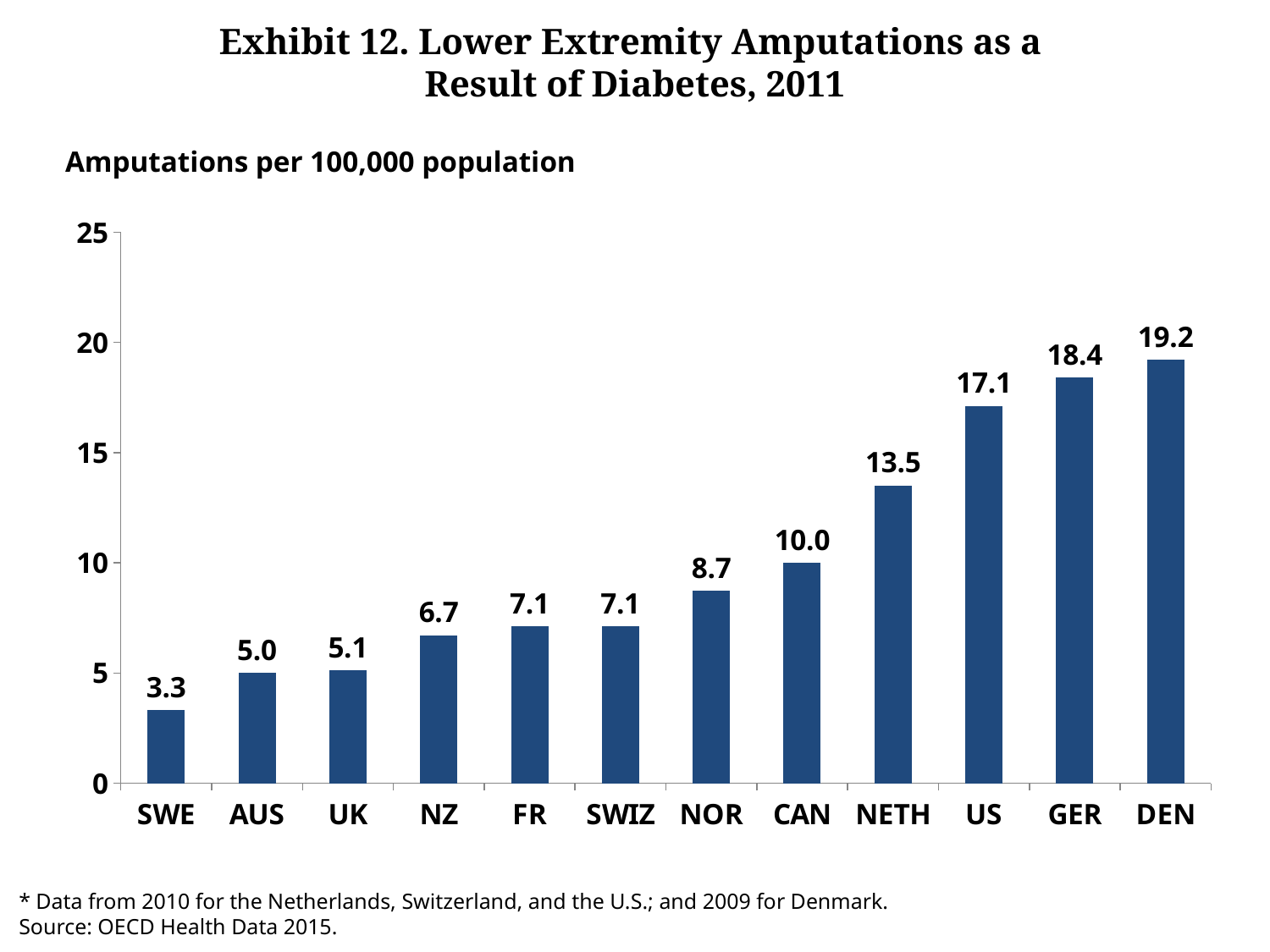
Which country has the highest value? DEN What is the difference between the values for GER and the US? 1.3 What is the value for the US? 17.1 How many countries are shown on the chart? 12 What kind of chart is shown on the slide? bar chart Which country has the lowest value? SWE Do the values rise or fall from left to right along the x axis? rise Is the value for NOR greater or less than 10? less What unit is given for the values on the chart? Amputations per 100,000 population What is the difference between the values for DEN and SWE? 15.9 Which is larger, the value for NETH or the value for CAN? NETH What is the value for NZ? 6.7